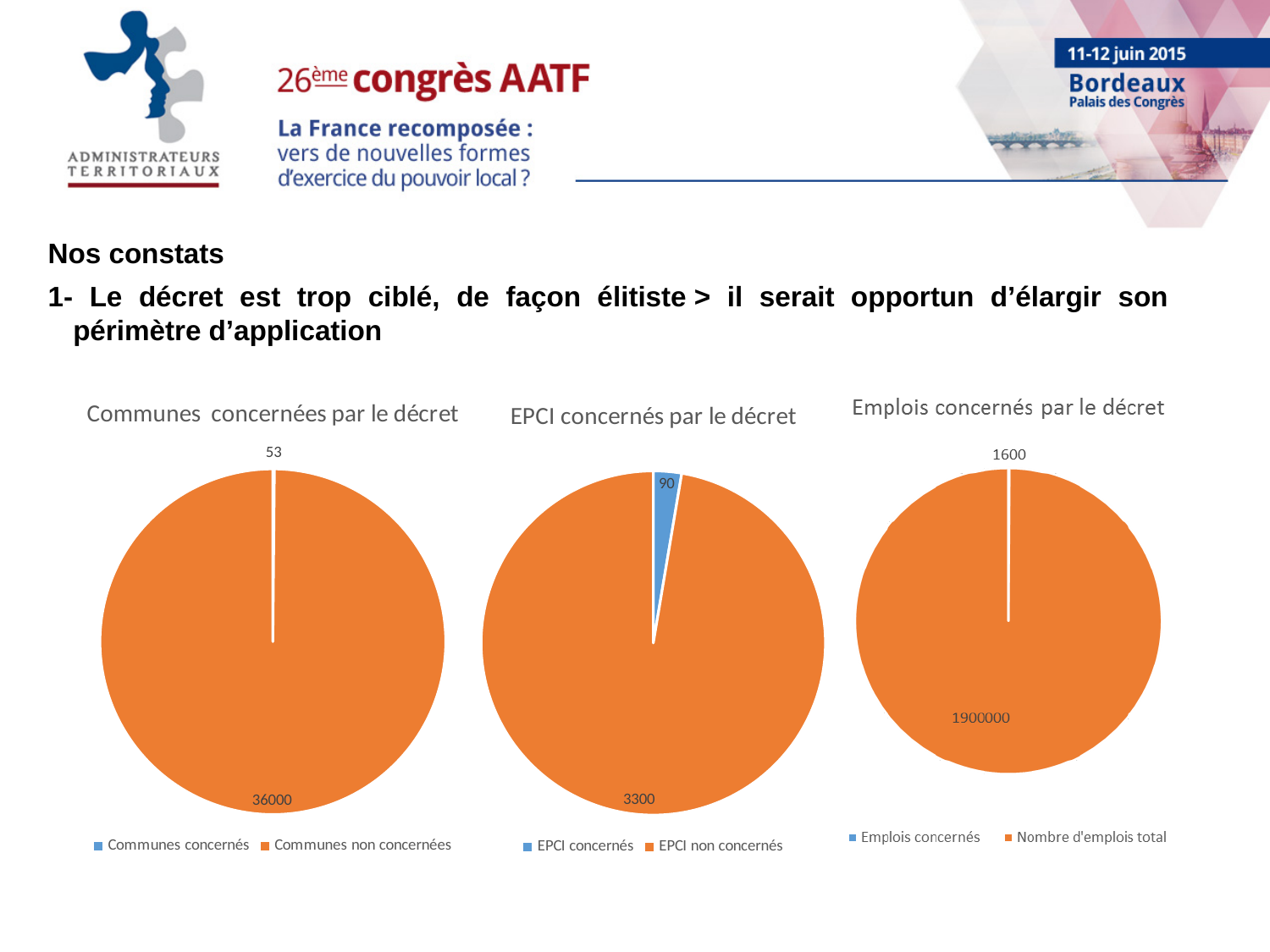
In the 'Emplois concernés par le décret' chart, what is the value for Nombre d'emplois total? 1900000 In the 'Emplois concernés par le décret' chart, which is larger: Emplois concernés or Nombre d'emplois total? Nombre d'emplois total In the 'Communes concernées par le décret' chart, which category is the smallest? Communes concernés How many charts are shown on the slide? 3 What kind of chart is the 'Communes concernées par le décret' chart? Pie chart In the 'EPCI concernés par le décret' chart, which category is the largest? EPCI non concernés In the 'Emplois concernés par le décret' chart, what is the value for Emplois concernés? 1600 In the 'EPCI concernés par le décret' chart, what is the difference between EPCI non concernés and EPCI concernés? 3210 In the 'EPCI concernés par le décret' chart, what is the value for EPCI concernés? 90 In the 'EPCI concernés par le décret' chart, what is the value for EPCI non concernés? 3300 In the 'Communes concernées par le décret' chart, what is the value for Communes concernés? 53 In the 'Communes concernées par le décret' chart, what is the value for Communes non concernées? 36000